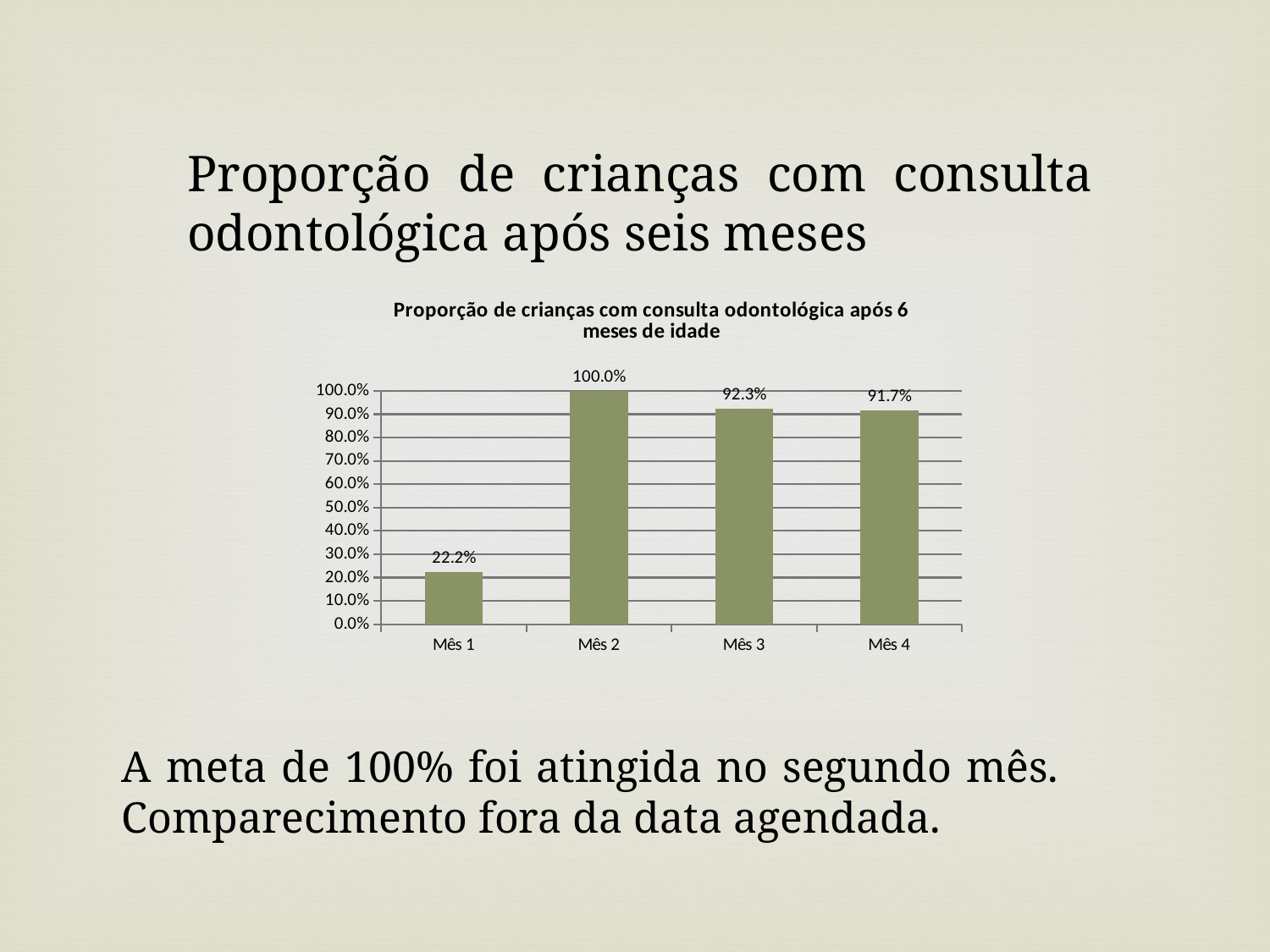
What kind of chart is shown on the slide? Bar chart What is the value for Mês 3? 92.3% What is the difference between the values for Mês 2 and Mês 1? 77.8% How many months are shown on the x axis? 4 Which month has the lowest value? Mês 1 What is the difference between the values for Mês 3 and Mês 4? 0.6% Which is larger, the value for Mês 1 or the value for Mês 3? Mês 3 Which month has the highest value? Mês 2 What is the value for Mês 4? 91.7% What is the value for Mês 1? 22.2% What is the title of the chart? Proporção de crianças com consulta odontológica após 6 meses de idade What is the value for Mês 2? 100.0%